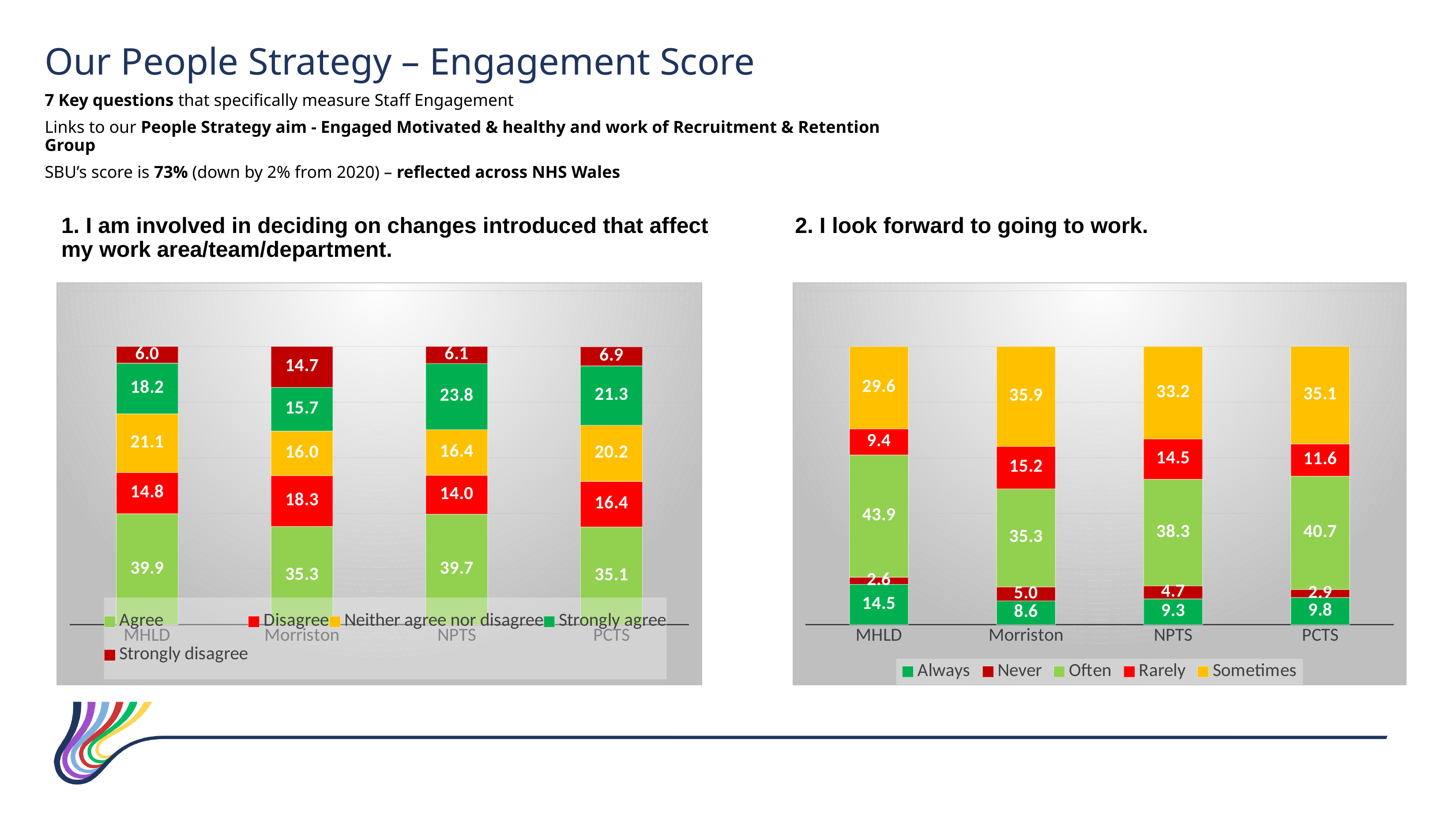
In the chart for question 2 (I look forward to going to work), what is the Often value for PCTS? 40.7 In the chart for question 2 (I look forward to going to work), what is the difference between the Rarely values for Morriston and MHLD? 5.8 In the chart for question 2 (I look forward to going to work), which site has the highest Always value? MHLD What type of chart is used for question 2 (I look forward to going to work)? Stacked bar chart In the chart for question 2 (I look forward to going to work), how many sites are shown on the x axis? 4 In the chart for question 1 (I am involved in deciding on changes), how many series does the legend list? 5 In the chart for question 1 (I am involved in deciding on changes), which site has the highest Strongly agree value? NPTS In the chart for question 2 (I look forward to going to work), which is larger, the Sometimes value for Morriston or for NPTS? Morriston In the chart for question 1 (I am involved in deciding on changes), what is the Agree value for MHLD? 39.9 In the chart for question 1 (I am involved in deciding on changes), which site has the lowest Agree value? PCTS In the chart for question 1 (I am involved in deciding on changes), what is the Strongly disagree value for Morriston? 14.7 In the chart for question 1 (I am involved in deciding on changes), what is the difference between the Disagree values for Morriston and NPTS? 4.3